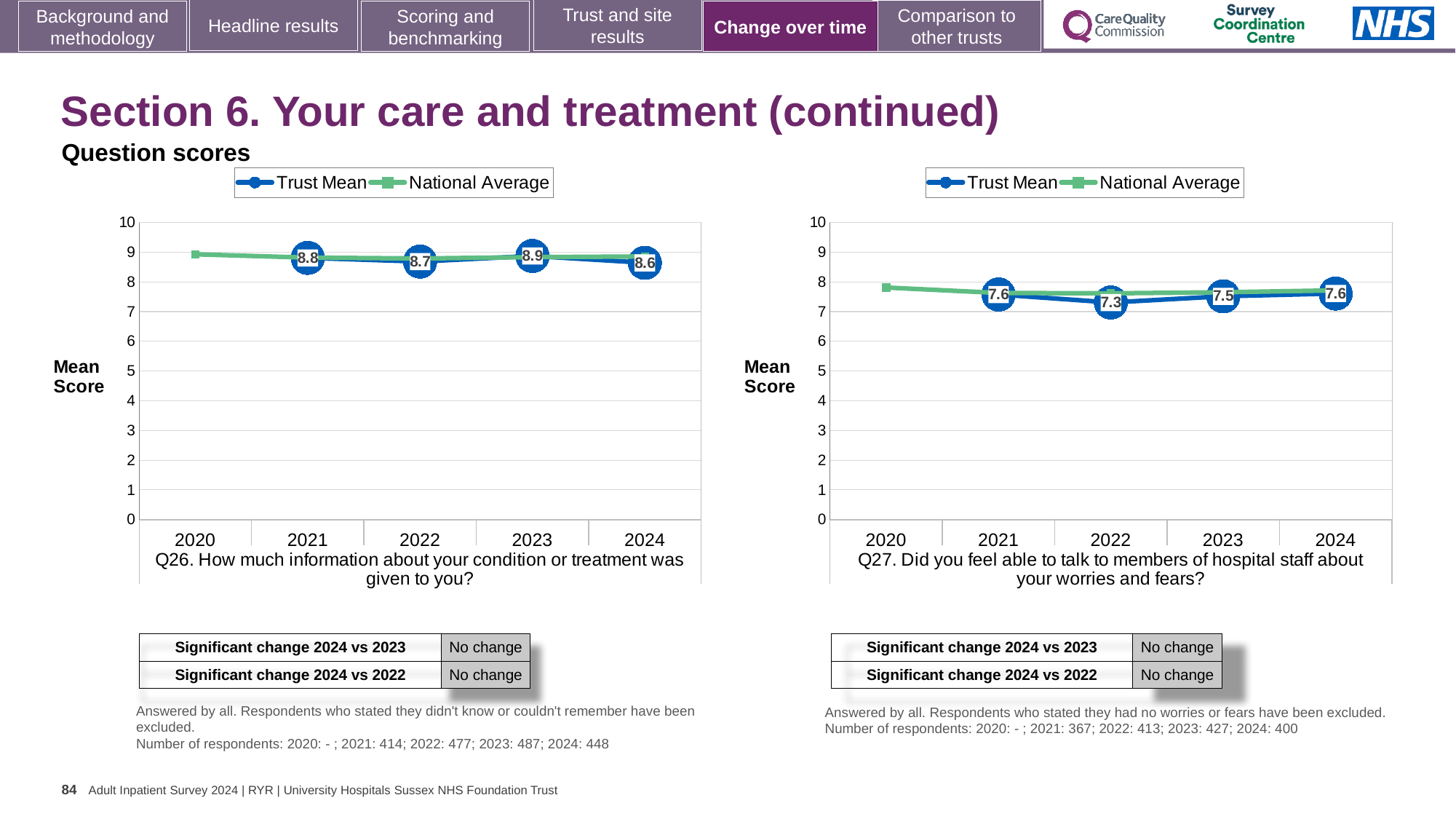
In the Q26 chart (left), what is the difference between the Trust Mean scores for 2023 and 2024? 0.3 In the Q26 chart (left), what is the Trust Mean score for 2024? 8.6 How many series does the legend of the Q26 chart (left) list? 2 What type of chart is the Q27 chart (right)? line chart In the Q27 chart (right), which year has the lowest Trust Mean score? 2022 In the Q27 chart (right), is the Trust Mean score for 2023 higher or lower than for 2022? higher In the Q26 chart (left), what is the Trust Mean score for 2021? 8.8 In the Q27 chart (right), is the National Average value for 2020 greater or less than 7? greater In the Q27 chart (right), what is the Trust Mean score for 2022? 7.3 In the Q26 chart (left), which year has the highest Trust Mean score? 2023 How many years are shown on the x axis of the Q26 chart (left)? 5 In the Q27 chart (right), what is the difference between the Trust Mean scores for 2024 and 2022? 0.3